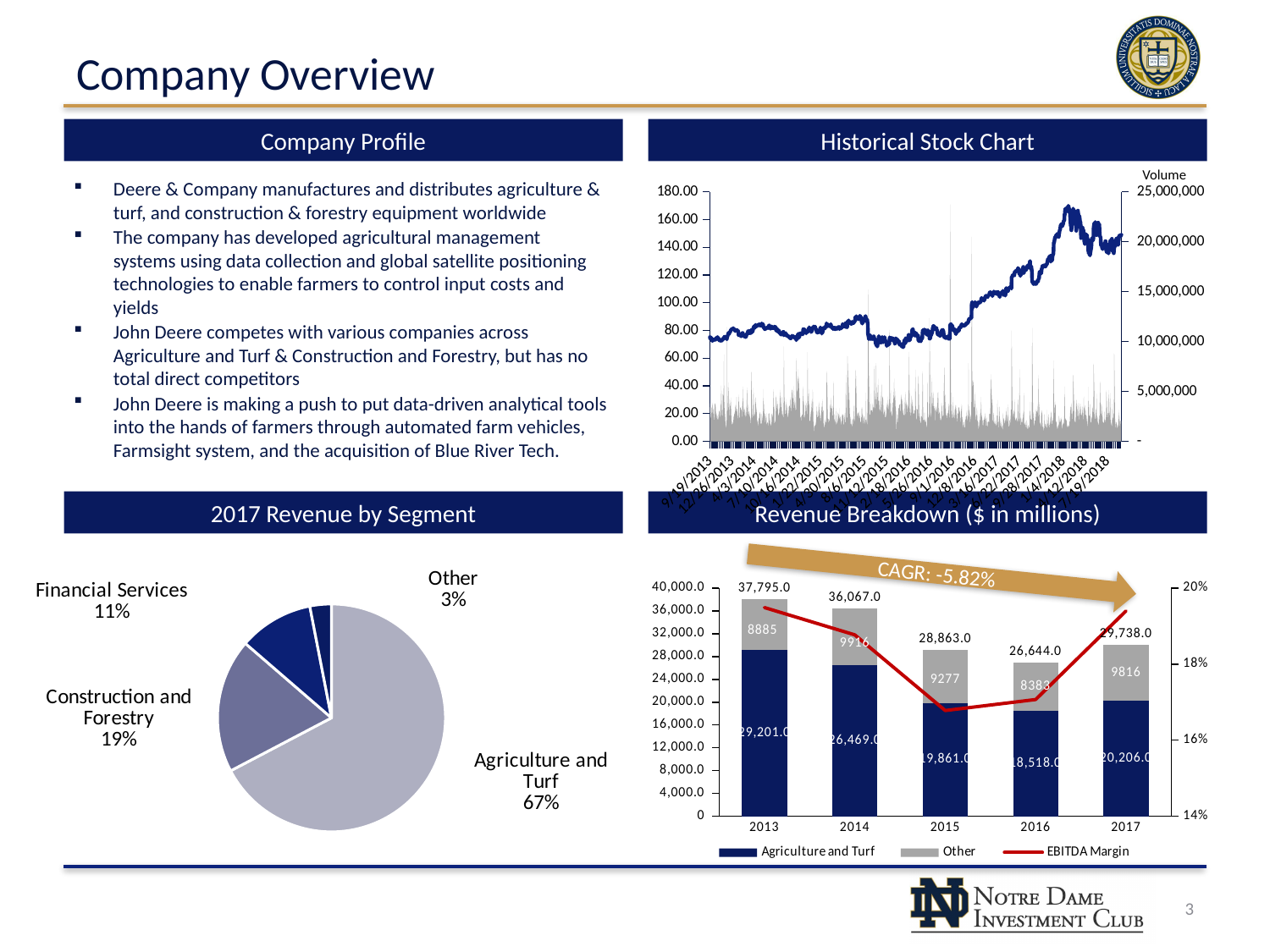
In the Historical Stock Chart, is the highest stock price reached greater or less than 160.00? greater In the 2017 Revenue by Segment chart, what share of revenue comes from Agriculture and Turf? 67% In the Revenue Breakdown chart, what is the difference between the total revenue in 2013 and 2014? 1,728.0 How many slices does the 2017 Revenue by Segment pie chart have? 4 In the Revenue Breakdown chart, what is the Other value for 2014? 9916 In the 2017 Revenue by Segment chart, which segment has the smallest share? Other In the Revenue Breakdown chart, what is the total revenue for 2013? 37,795.0 What kind of chart is the 2017 Revenue by Segment chart? Pie chart In the Revenue Breakdown chart, which year has the lowest total revenue? 2016 How many series does the legend of the Revenue Breakdown chart list? 3 In the Revenue Breakdown chart, what is the Agriculture and Turf value for 2017? 20,206.0 In the 2017 Revenue by Segment chart, what share of revenue comes from Construction and Forestry? 19%